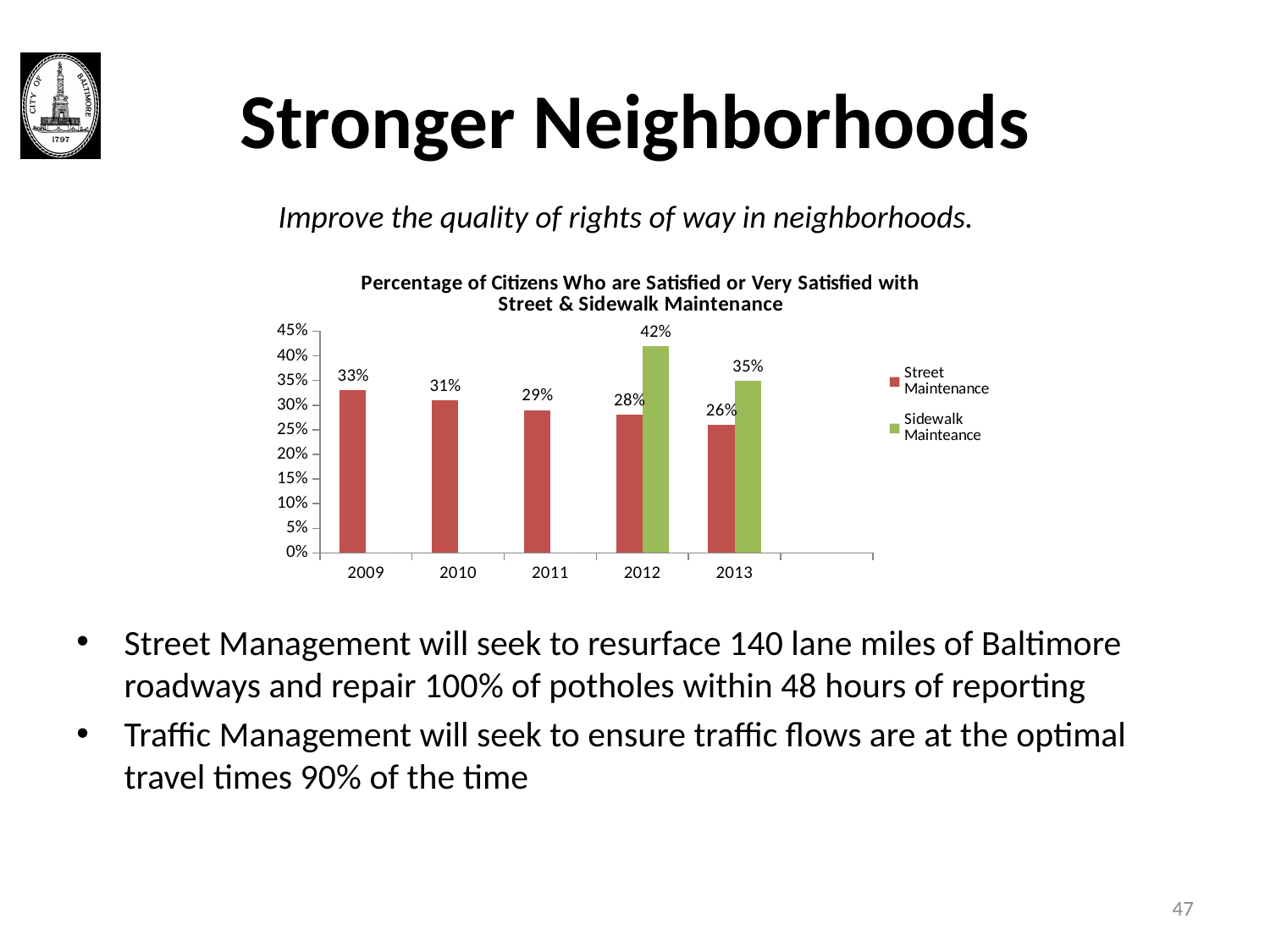
Which year has the lowest Street Maintenance value? 2013 What is the Street Maintenance value for 2009? 33% What is the difference between the Sidewalk Mainteance value in 2012 and in 2013? 7% Which year has the highest Street Maintenance value? 2009 Do the Street Maintenance values rise or fall from 2009 to 2013? Fall Which is larger in 2013, Street Maintenance or Sidewalk Mainteance? Sidewalk Mainteance Is the Street Maintenance value for 2011 greater or less than 25%? greater What kind of chart is shown on the slide? Bar chart What is the Sidewalk Mainteance value for 2012? 42% How many years are shown on the x axis? 5 How many series does the legend list? 2 What is the Street Maintenance value for 2013? 26%